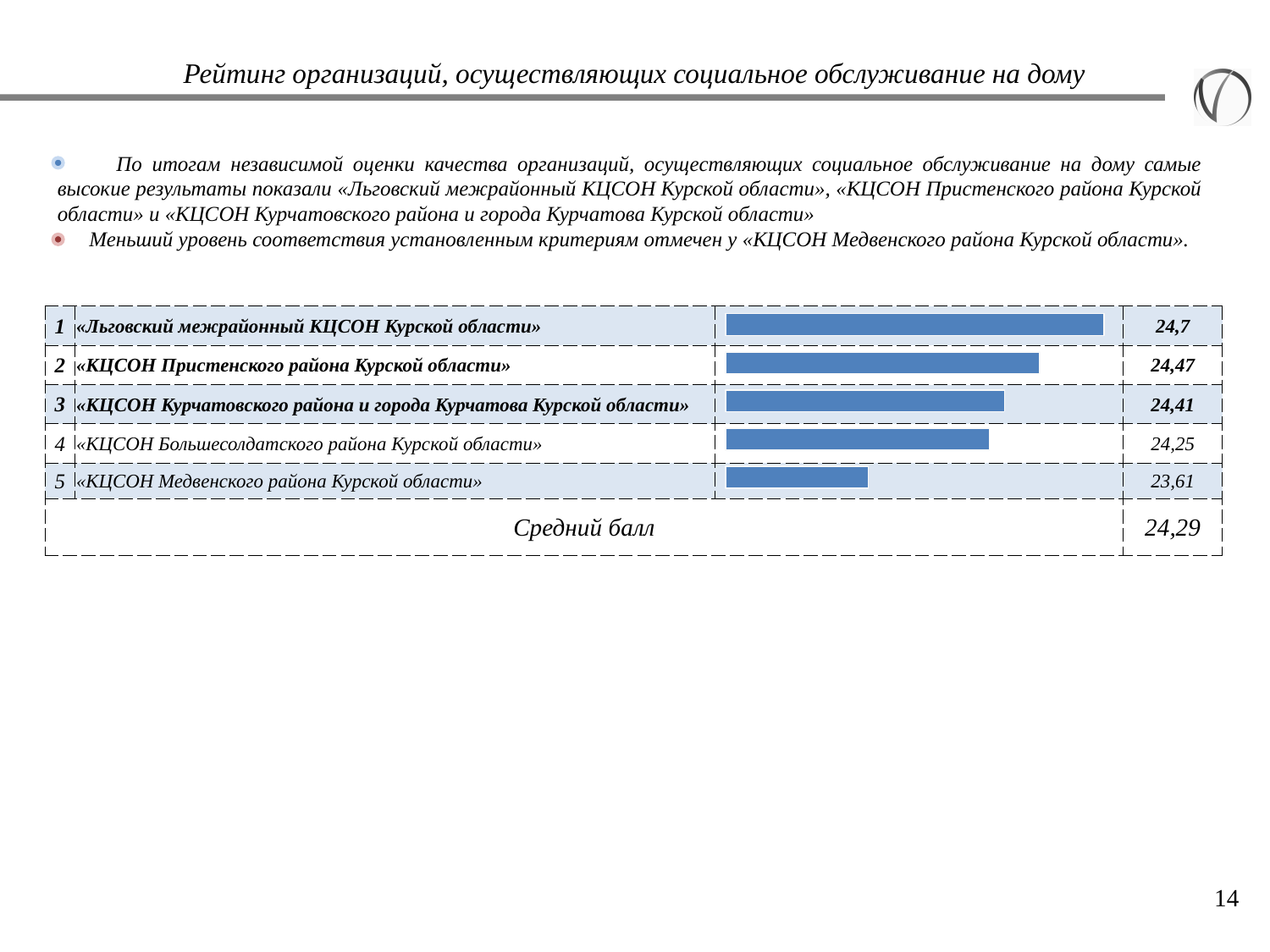
What is the value for «КЦСОН Медвенского района Курской области»? 23,61 Which organisation has the highest value? «Льговский межрайонный КЦСОН Курской области» What is the value for «КЦСОН Курчатовского района и города Курчатова Курской области»? 24,41 What is the value for «КЦСОН Большесолдатского района Курской области»? 24,25 Which organisation has the lowest value? «КЦСОН Медвенского района Курской области» What kind of chart is shown on the slide? bar chart How many organisations are ranked in the chart? 5 What is the difference between the values for «Льговский межрайонный КЦСОН Курской области» and «КЦСОН Медвенского района Курской области»? 1,09 Which is larger: the value for «КЦСОН Большесолдатского района Курской области» or «КЦСОН Медвенского района Курской области»? «КЦСОН Большесолдатского района Курской области» What is the value for «КЦСОН Пристенского района Курской области»? 24,47 What is the value for «Льговский межрайонный КЦСОН Курской области»? 24,7 What is the value shown for «Средний балл»? 24,29